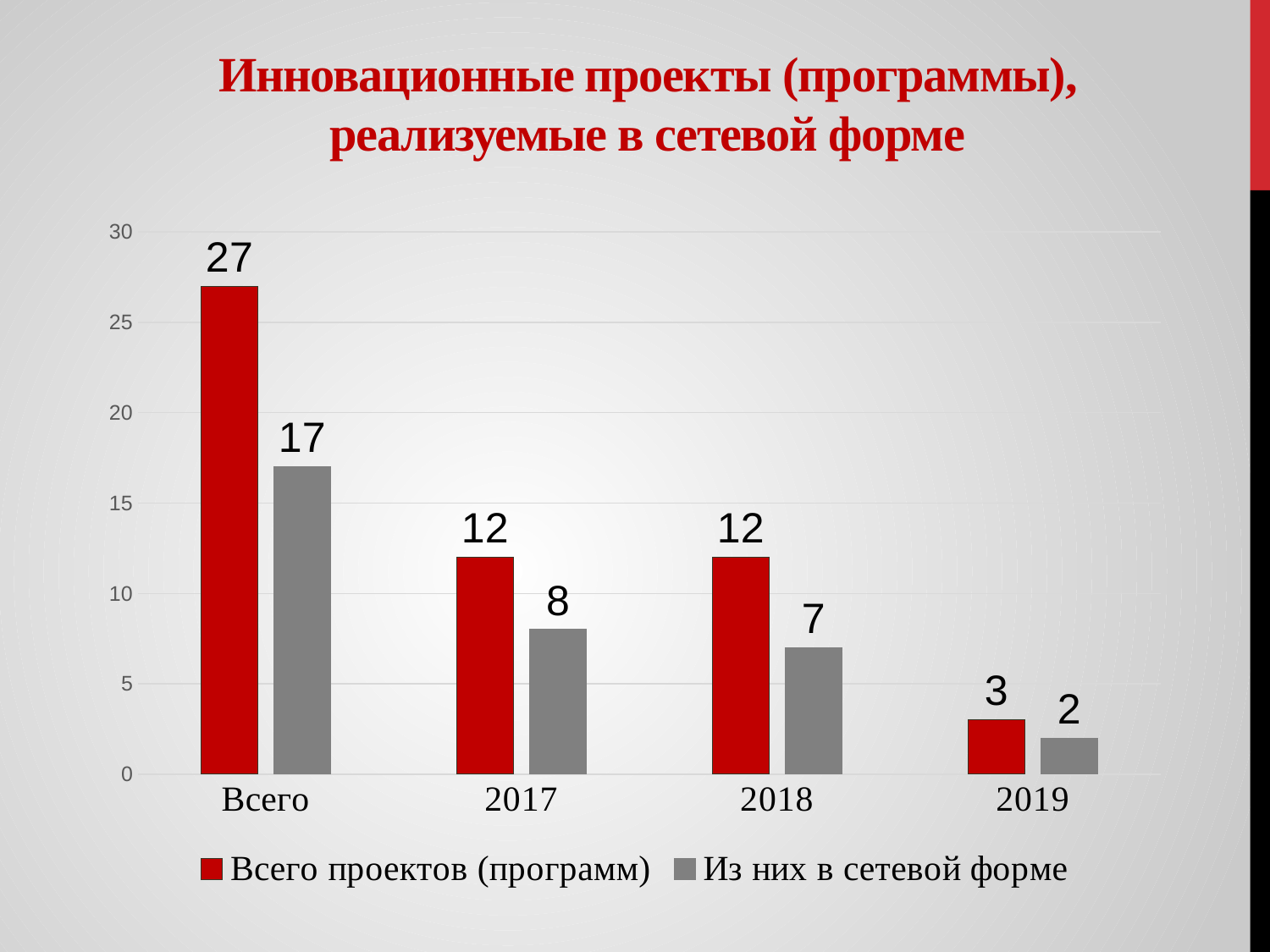
What is the value of "Из них в сетевой форме" for 2018? 7 What is the value of "Из них в сетевой форме" for the "Всего" category? 17 What is the value of "Всего проектов (программ)" for 2017? 12 Which is larger: "Из них в сетевой форме" for 2017 or for 2018? 2017 What colour are the bars for "Всего проектов (программ)"? Red What is the difference between "Всего проектов (программ)" and "Из них в сетевой форме" for 2017? 4 How many series does the legend list? 2 Which year has the lowest value for "Из них в сетевой форме"? 2019 Which category has the highest value for "Всего проектов (программ)"? Всего What is the difference between "Всего проектов (программ)" and "Из них в сетевой форме" in the "Всего" category? 10 What kind of chart is shown on the slide? Bar chart How many categories are shown on the x axis? 4